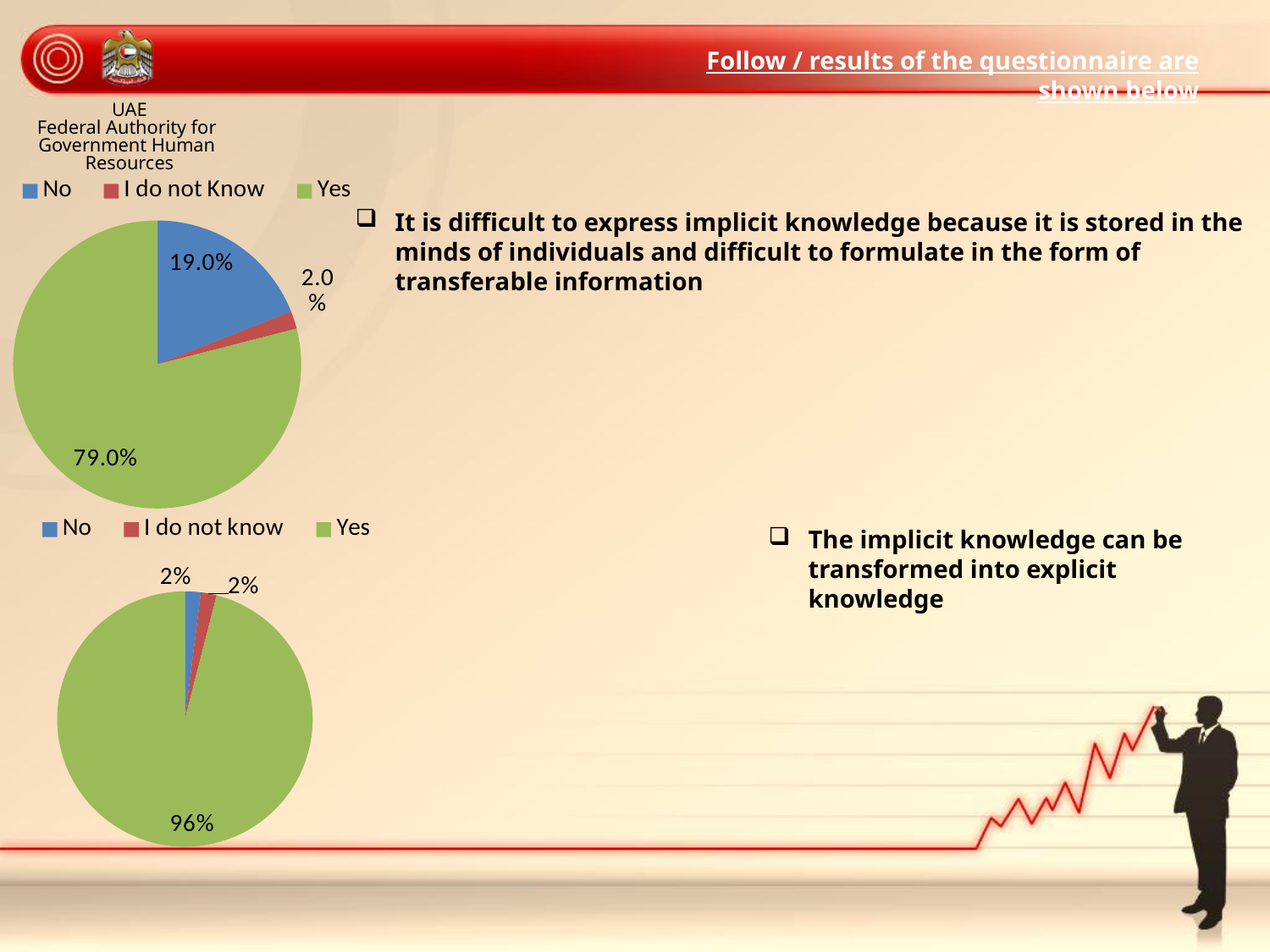
In the top pie chart, what percentage is shown for the No slice? 19.0% In the top pie chart, which category has the largest share? Yes How many categories does the legend of the bottom pie chart list? 3 In the top pie chart, what percentage is shown for the Yes slice? 79.0% What type of chart is the top chart on the slide? Pie chart In the bottom pie chart, what percentage is shown for the No slice? 2% In the top pie chart, which is larger, the No slice or the 'I do not Know' slice? No In the bottom pie chart, which category has the largest share? Yes In the top pie chart, what percentage is shown for the 'I do not Know' slice? 2.0% In the bottom pie chart, what percentage is shown for the Yes slice? 96% In the top pie chart, which category has the smallest share? I do not Know In the top pie chart, what is the difference between the Yes and No percentages? 60.0%